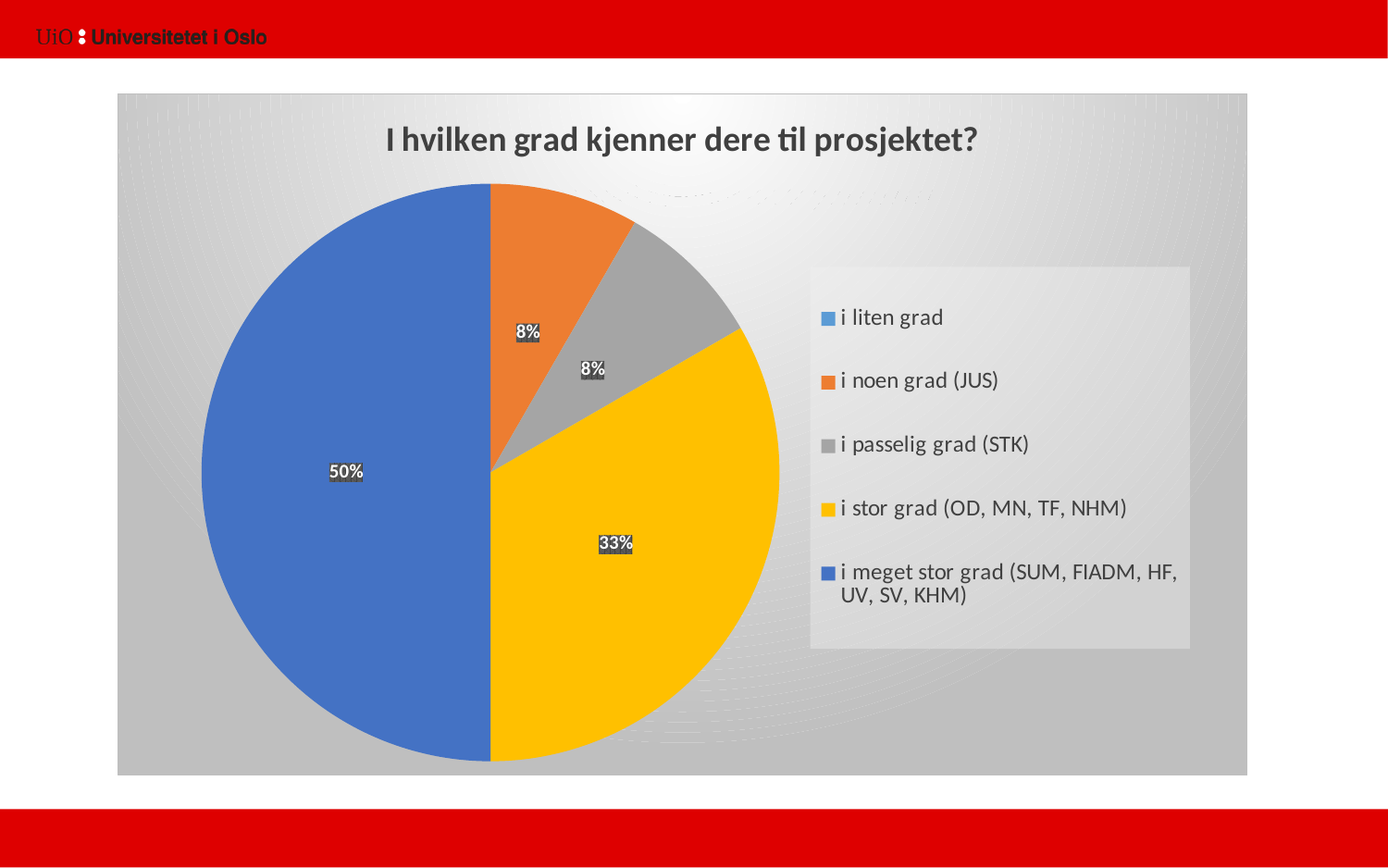
Which category has the largest slice of the pie? i meget stor grad (SUM, FIADM, HF, UV, SV, KHM) How many slices with data labels are visible in the pie? 4 What is the difference in percentage points between the 'i meget stor grad' slice and the 'i stor grad' slice? 17 What is the title of the chart? I hvilken grad kjenner dere til prosjektet? What colour is the slice for 'i stor grad (OD, MN, TF, NHM)'? yellow What percentage is shown for the slice 'i noen grad (JUS)'? 8% What type of chart is shown on the slide? pie chart What percentage is shown for the slice 'i stor grad (OD, MN, TF, NHM)'? 33% Which slice is larger: 'i stor grad (OD, MN, TF, NHM)' or 'i passelig grad (STK)'? i stor grad (OD, MN, TF, NHM) What percentage is shown for the slice 'i passelig grad (STK)'? 8% How many entries does the legend list? 5 What percentage is shown for the slice 'i meget stor grad (SUM, FIADM, HF, UV, SV, KHM)'? 50%